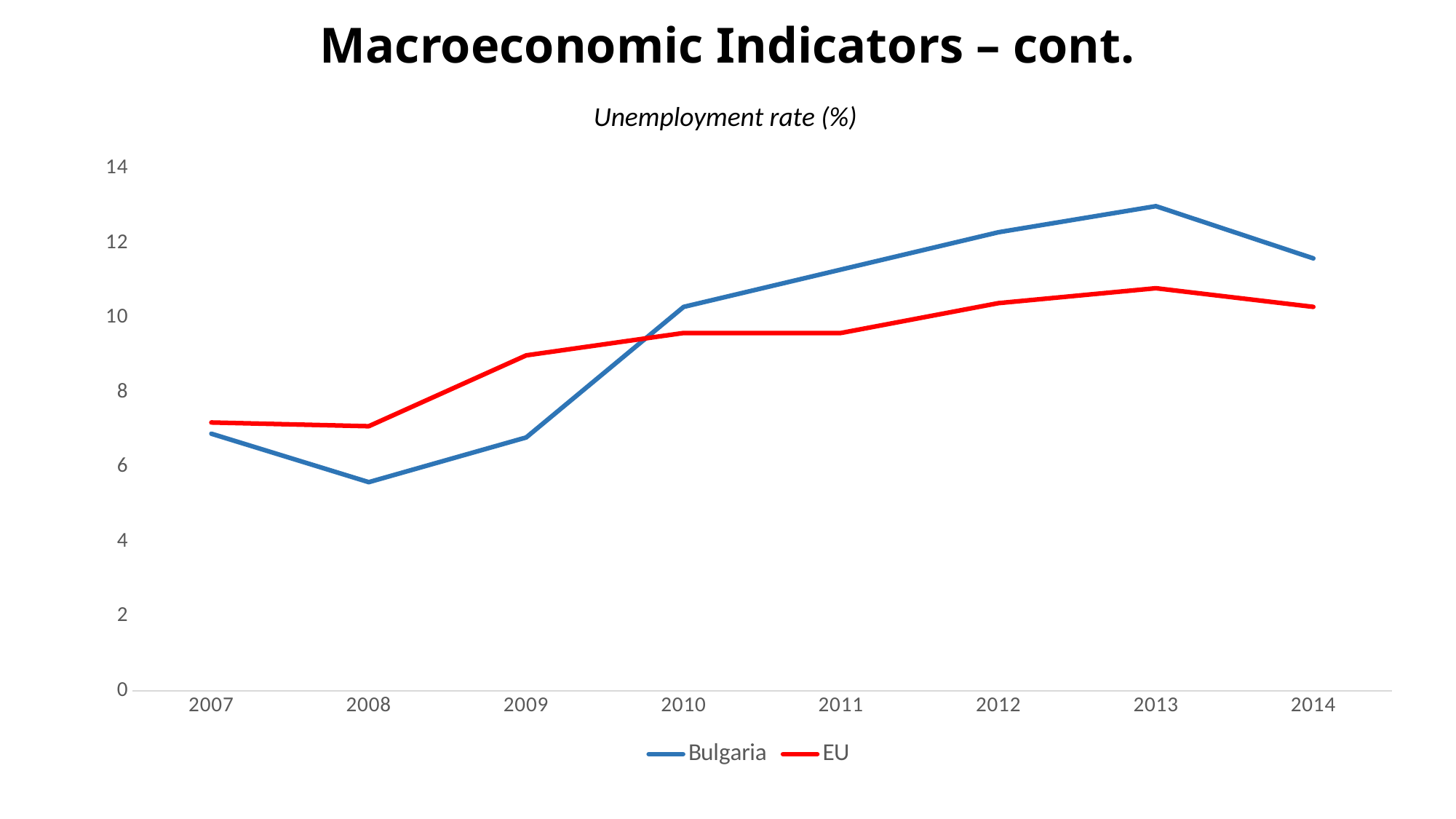
In 2013, which series has the higher unemployment rate, Bulgaria or EU? Bulgaria Is the value for Bulgaria in 2008 greater or less than 6? less Is the value for Bulgaria in 2013 greater or less than 12? greater Does the unemployment rate for Bulgaria rise or fall from 2008 to 2013? rise What is the title of the chart? Unemployment rate (%) In 2008, which series has the higher unemployment rate, Bulgaria or EU? EU How many years are plotted along the x axis? 8 In which year is the unemployment rate for Bulgaria lowest? 2008 What kind of chart is shown on the slide? line chart In which year is the unemployment rate for Bulgaria highest? 2013 In which year is the unemployment rate for the EU highest? 2013 How many series does the legend list? 2